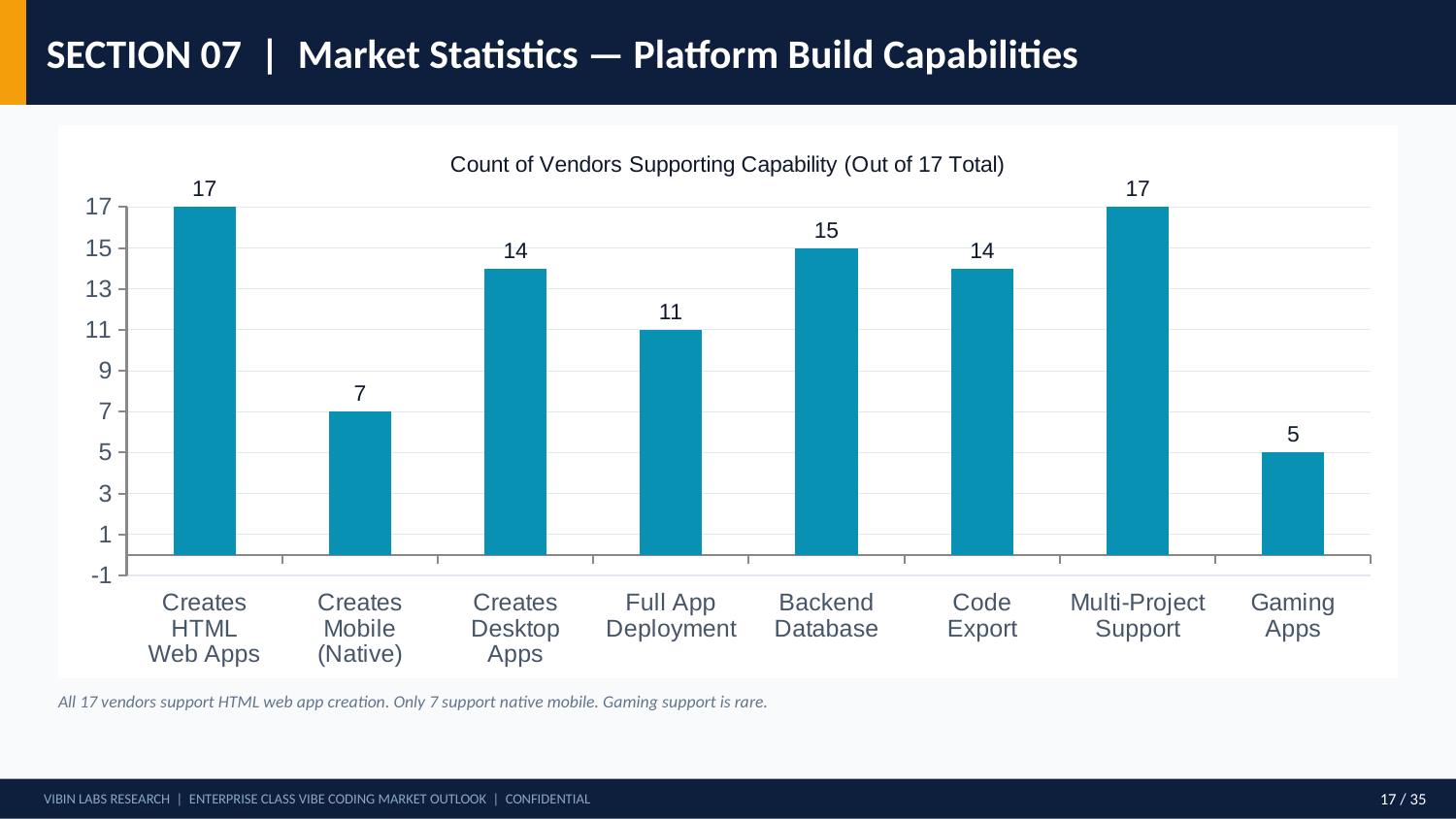
Which is larger, the value for Creates Desktop Apps or the value for Full App Deployment? Creates Desktop Apps What is the difference between the values for Creates HTML Web Apps and Creates Mobile (Native)? 10 How many capability categories are shown on the chart? 8 Which capability has the lowest count of vendors? Gaming Apps What is the difference between the values for Backend Database and Gaming Apps? 10 What is the value for Backend Database? 15 What is the title of the chart? Count of Vendors Supporting Capability (Out of 17 Total) Which two capabilities both have a value of 17? Creates HTML Web Apps and Multi-Project Support How many vendors support Creates Mobile (Native)? 7 Is the value for Code Export greater or less than 9? greater What is the value for Full App Deployment? 11 What kind of chart is shown on the slide? Bar chart